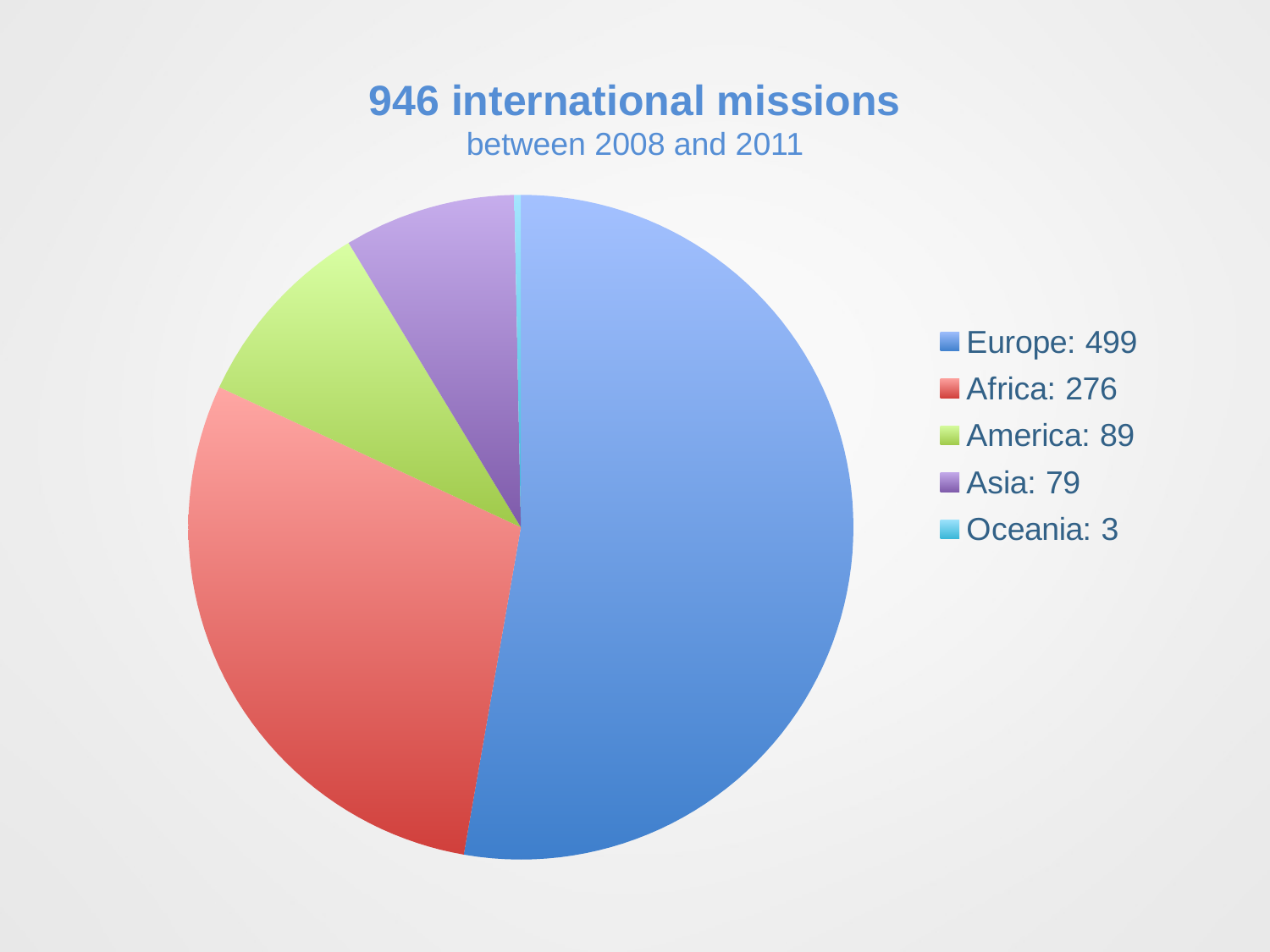
How many international missions does the legend give for Europe? 499 Which has more missions, America or Asia? America What type of chart is shown on the slide? Pie chart What is the difference between the number of missions in Europe and in Africa? 223 How many regions are shown in the pie chart? 5 How many international missions does the legend give for Africa? 276 Which region has the smallest slice of the pie? Oceania How many international missions does the legend give for Oceania? 3 What is the title of the chart? 946 international missions between 2008 and 2011 What is the difference between the number of missions in America and in Asia? 10 How many international missions does the legend give for Asia? 79 Which region has the largest slice of the pie? Europe